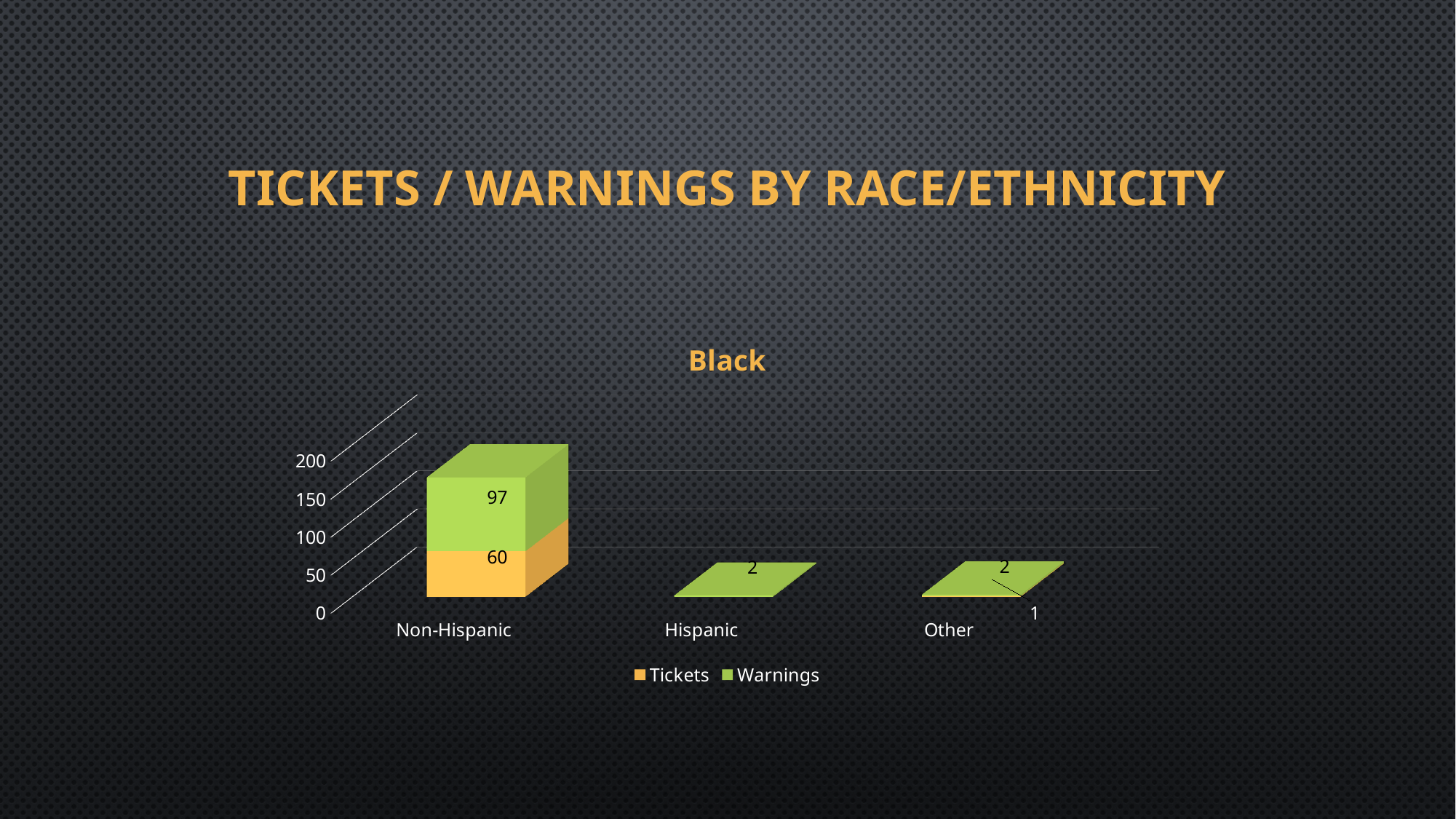
What is the difference between the Warnings and Tickets values for Non-Hispanic in the Black chart? 37 How many series does the legend of the Black chart list? 2 What is the Warnings value for Non-Hispanic in the Black chart? 97 What is the Tickets value for Non-Hispanic in the Black chart? 60 What is the total of the stacked bar for Non-Hispanic in the Black chart? 157 What is the Tickets value for Other in the Black chart? 1 What kind of chart is shown on the slide? Stacked bar chart How many categories are shown on the x axis of the Black chart? 3 What is the Warnings value for Other in the Black chart? 2 What is the total of the stacked bar for Other in the Black chart? 3 Which category has the highest Warnings value in the Black chart? Non-Hispanic What is the Warnings value for Hispanic in the Black chart? 2